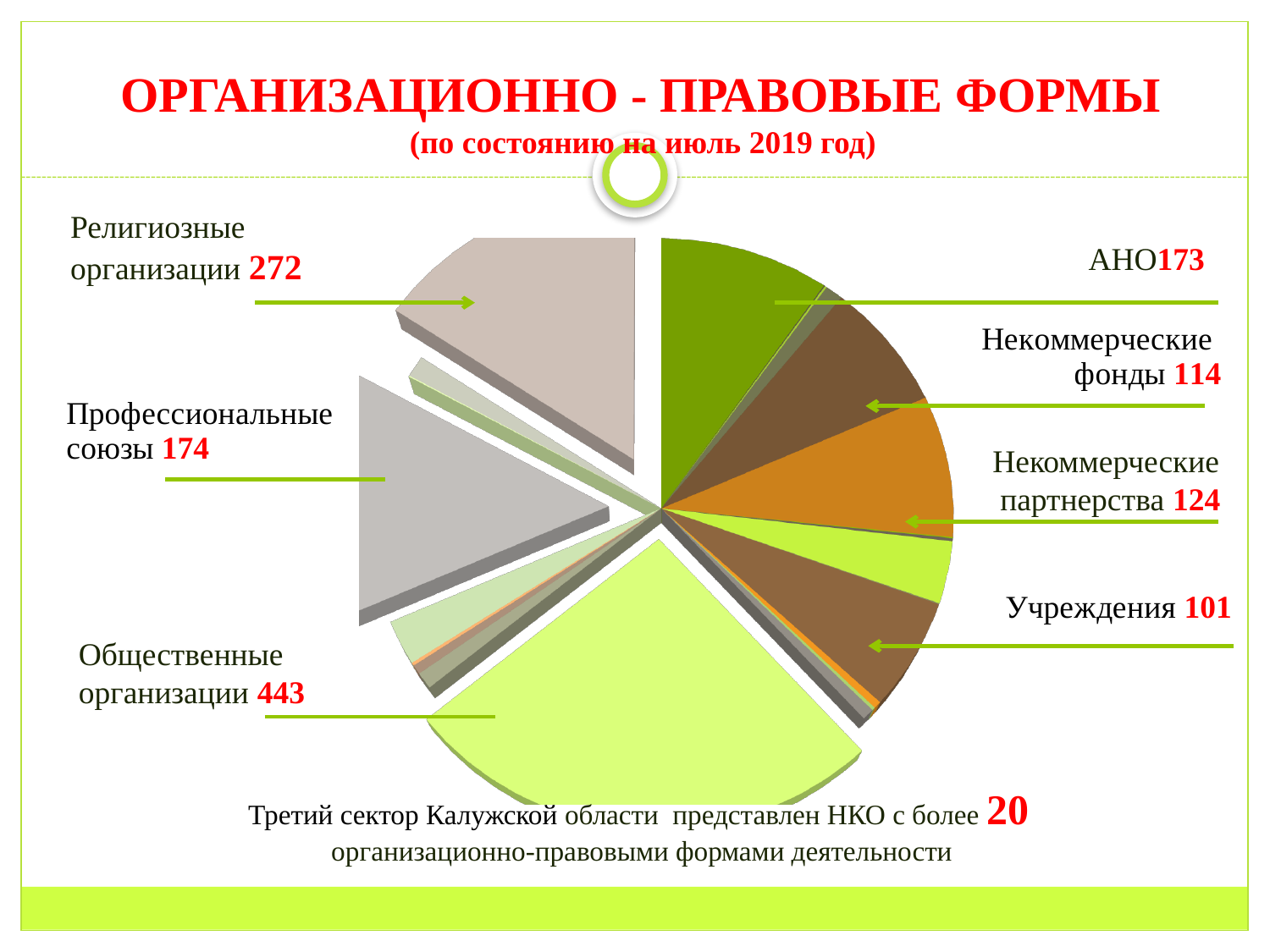
What kind of chart is shown on the slide? pie chart Which labelled category has the smallest value? Учреждения What value is shown for Общественные организации? 443 What value is shown for Профессиональные союзы? 174 What is the difference between the values for Общественные организации and Религиозные организации? 171 What value is shown for Учреждения? 101 According to the subtitle, as of what date is the data shown? июль 2019 год What value is shown for Некоммерческие фонды? 114 What value is shown for Религиозные организации? 272 Which is larger, the value for Некоммерческие партнерства or the value for Некоммерческие фонды? Некоммерческие партнерства What value is shown for АНО? 173 Which labelled category has the largest value? Общественные организации